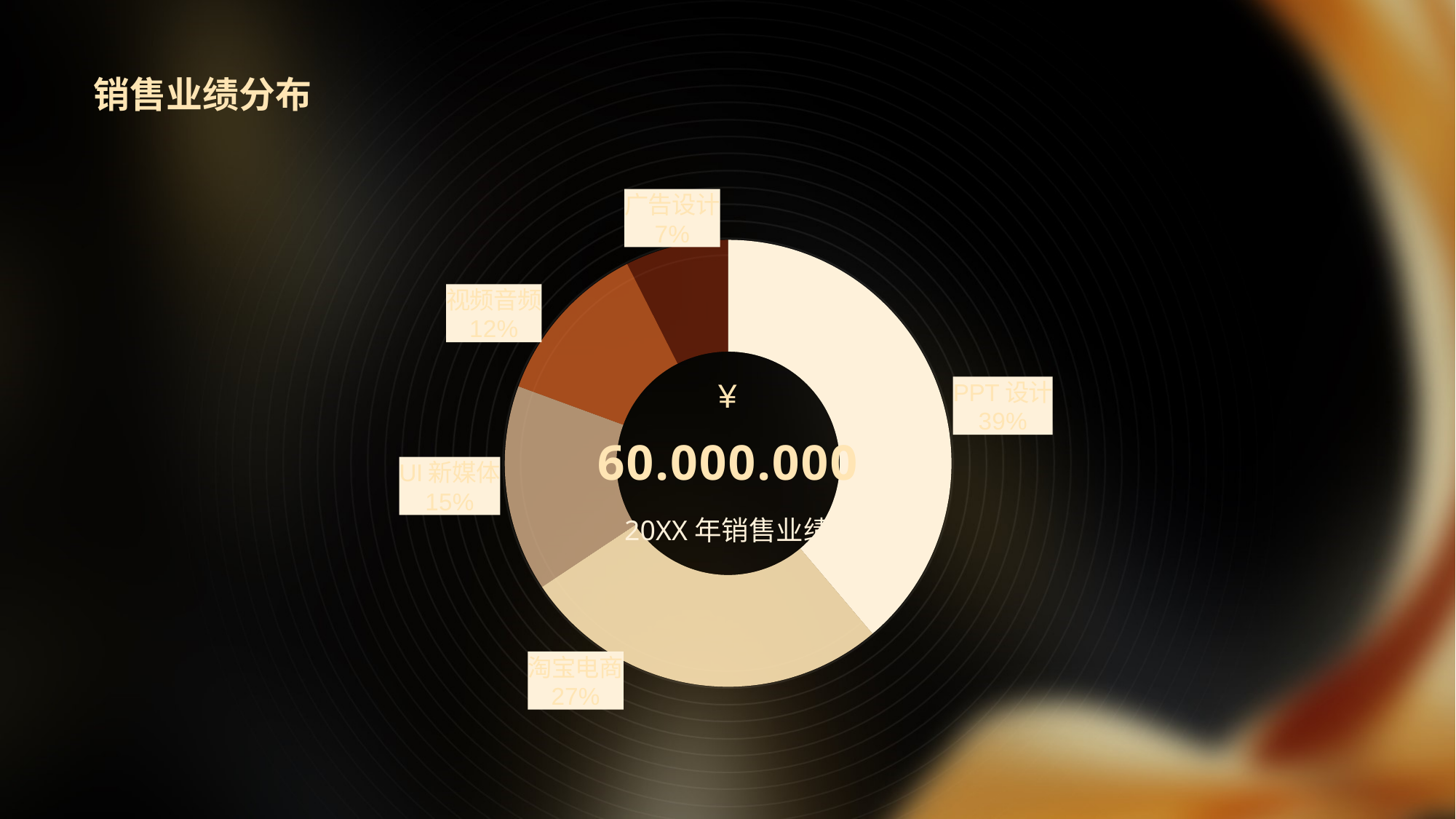
Which category has the smallest share of the chart? 广告设计 What percentage share does PPT 设计 have? 39% What total amount is shown in the centre of the chart? ¥ 60.000.000 What percentage share does 视频音频 have? 12% What kind of chart is shown on the slide? Doughnut chart Which has a larger share, UI 新媒体 or 视频音频? UI 新媒体 What percentage share does 淘宝电商 have? 27% How many categories are shown in the chart? 5 What percentage share does UI 新媒体 have? 15% Which category has the largest share of the chart? PPT 设计 What is the difference in percentage points between PPT 设计 and 淘宝电商? 12 What percentage share does 广告设计 have? 7%